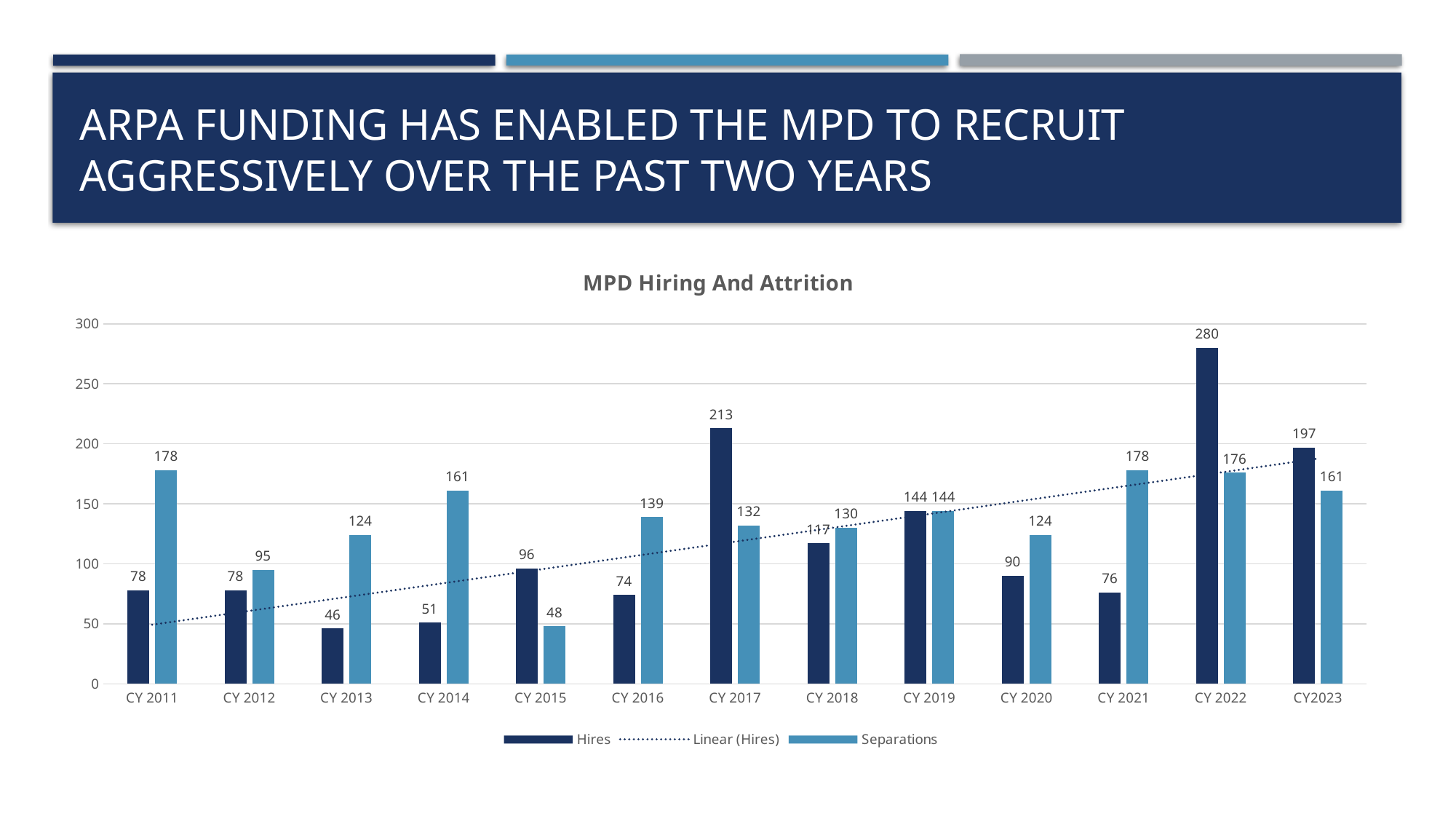
What kind of chart is shown on the slide? Bar chart What is the number of Hires in CY 2022? 280 How many entries does the legend list? 3 Which year has the lowest number of Hires? CY 2013 What is the difference between Hires and Separations in CY 2022? 104 Which year has the lowest number of Separations? CY 2015 What is the number of Separations in CY 2011? 178 Which year has the highest number of Hires? CY 2022 What is the title of the chart? MPD Hiring And Attrition Which is larger in CY 2014, Hires or Separations? Separations What is the number of Hires in CY 2017? 213 How many years are shown on the x axis? 13